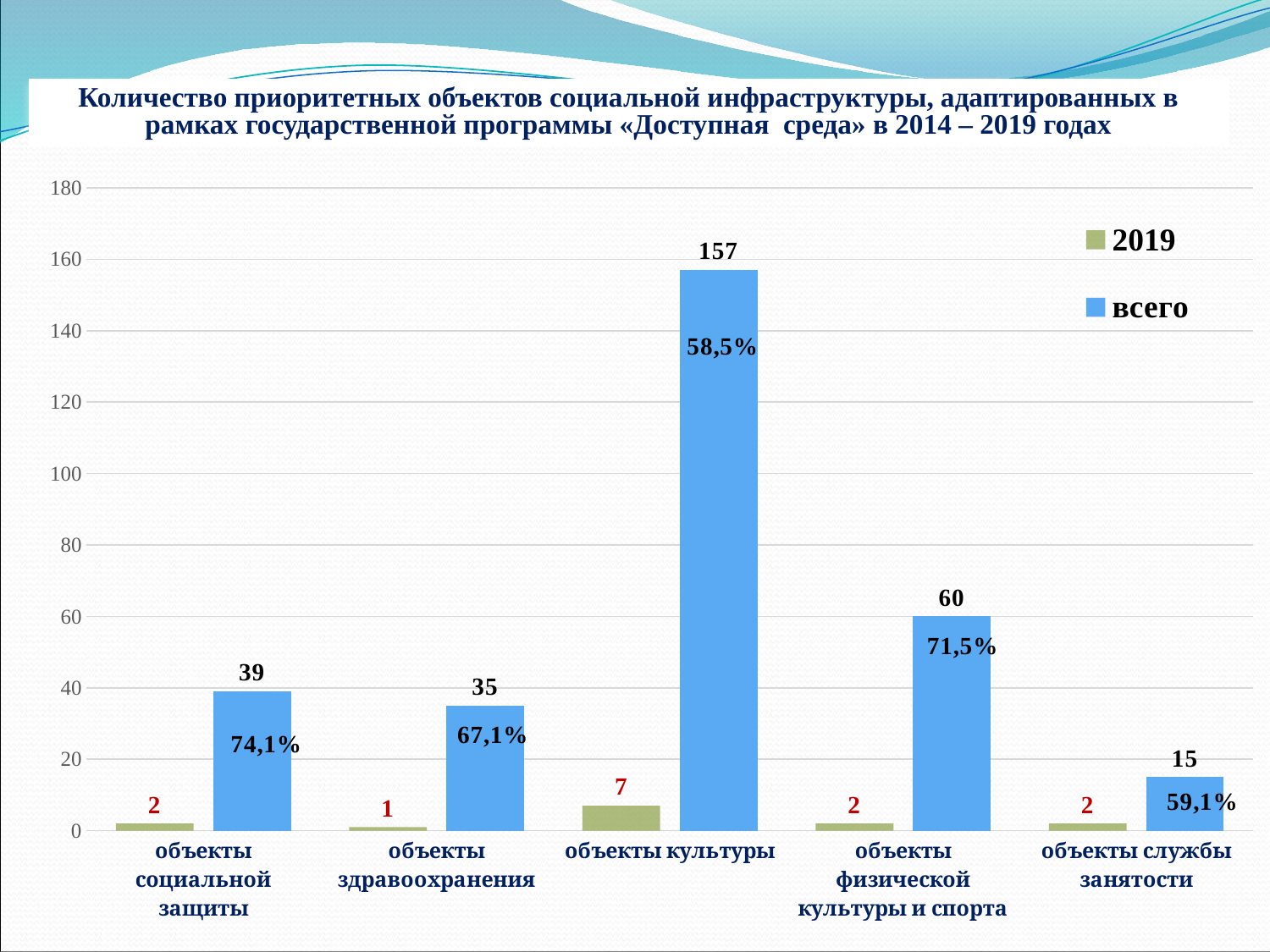
Which category has the highest 'всего' value? объекты культуры What is the difference between the 'всего' values for объекты культуры and объекты физической культуры и спорта? 97 How many series does the legend list? 2 What is the 'всего' value for объекты службы занятости? 15 Which is larger: the 'всего' value for объекты социальной защиты or for объекты здравоохранения? объекты социальной защиты How many categories are shown on the x axis? 5 What colour are the 'всего' bars? blue Which category has the lowest 2019 value? объекты здравоохранения What kind of chart is shown on the slide? bar chart What percentage is shown on the 'всего' bar for объекты физической культуры и спорта? 71,5% What is the 'всего' value for объекты культуры? 157 What is the 2019 value for объекты здравоохранения? 1